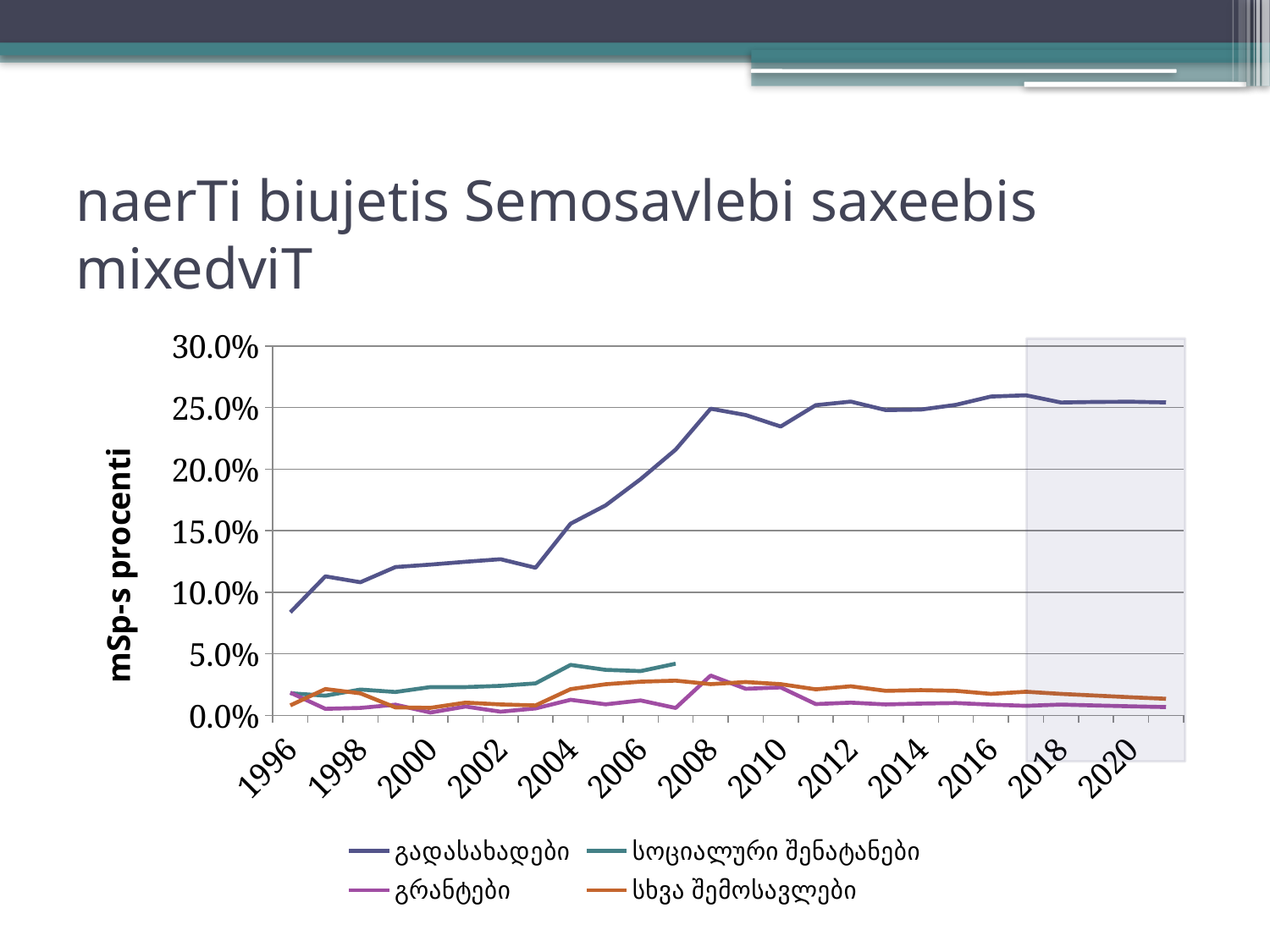
In 2012, which is larger: სხვა შემოსავლები or გრანტები? სხვა შემოსავლები Which series has the highest values across the whole period? გადასახადები Is the value for გადასახადები in 2008 greater or less than 20.0%? greater Is the value for გადასახადები in 2016 greater or less than 25.0%? greater Is the value for გადასახადები in 1996 greater or less than 10.0%? less What is the label on the vertical axis? mSp-s procenti In 2004, which is larger: გადასახადები or სოციალური შენატანები? გადასახადები How many series does the legend list? 4 Does the გადასახადები series rise or fall from 1996 to 2008? rise What kind of chart is shown on the slide? line chart What is the title of the slide? naerTi biujetis Semosavlebi saxeebis mixedviT